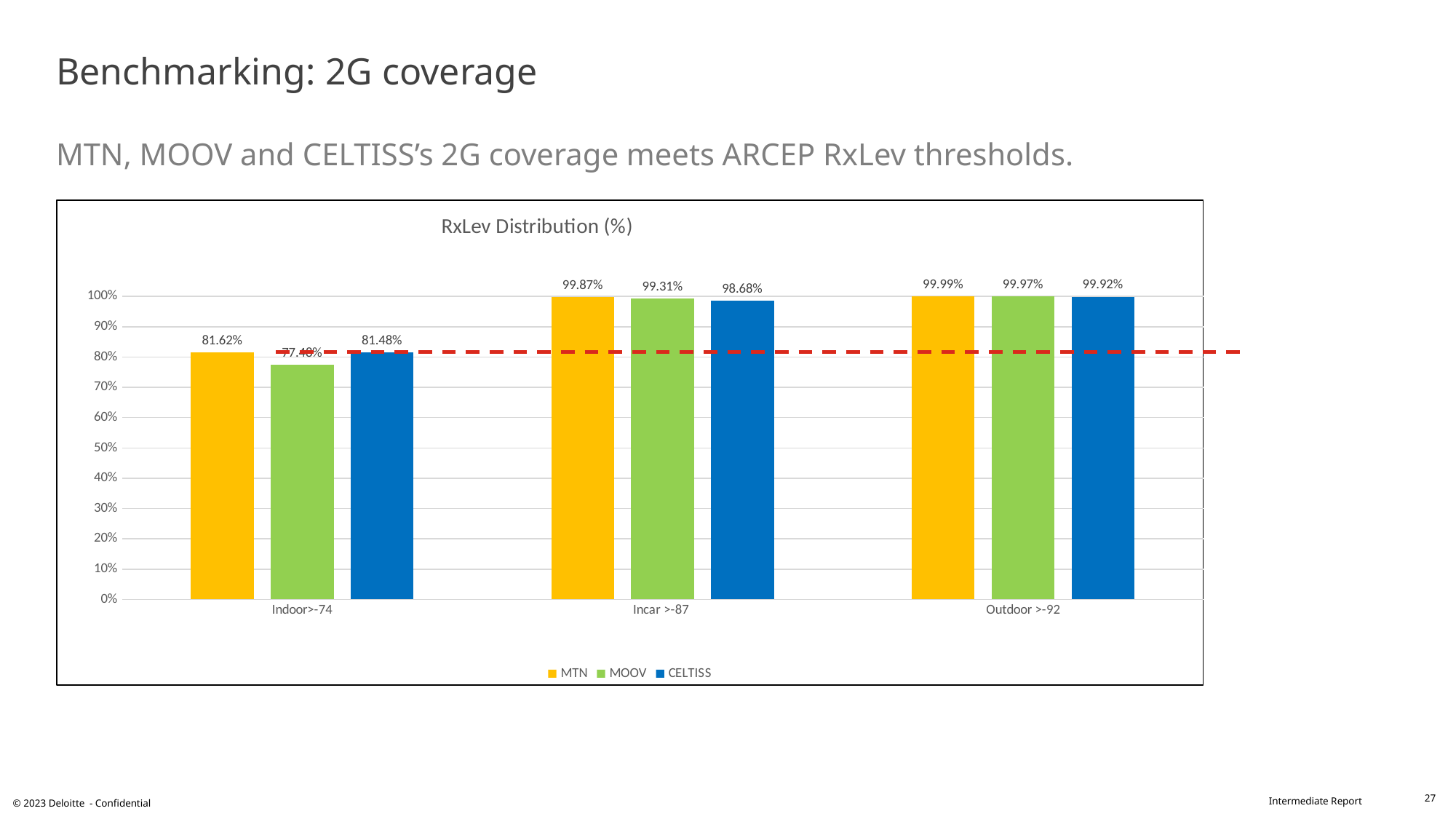
What type of chart is shown on the slide? Bar chart What is the title of the chart? RxLev Distribution (%) What is the value for MOOV in the Outdoor >-92 category? 99.97% What is the value for MTN in the Indoor>-74 category? 81.62% Is the value for MOOV in the Indoor>-74 category greater or less than 80%? less How many categories are shown on the x axis? 3 How many series does the legend list? 3 What is the difference between the MTN and CELTISS values in the Incar >-87 category? 1.19 percentage points Do the MTN values rise or fall from Indoor>-74 to Outdoor >-92? Rise Which operator has the lowest value in the Indoor>-74 category? MOOV What is the value for CELTISS in the Incar >-87 category? 98.68% Which operator has the highest value in the Outdoor >-92 category? MTN